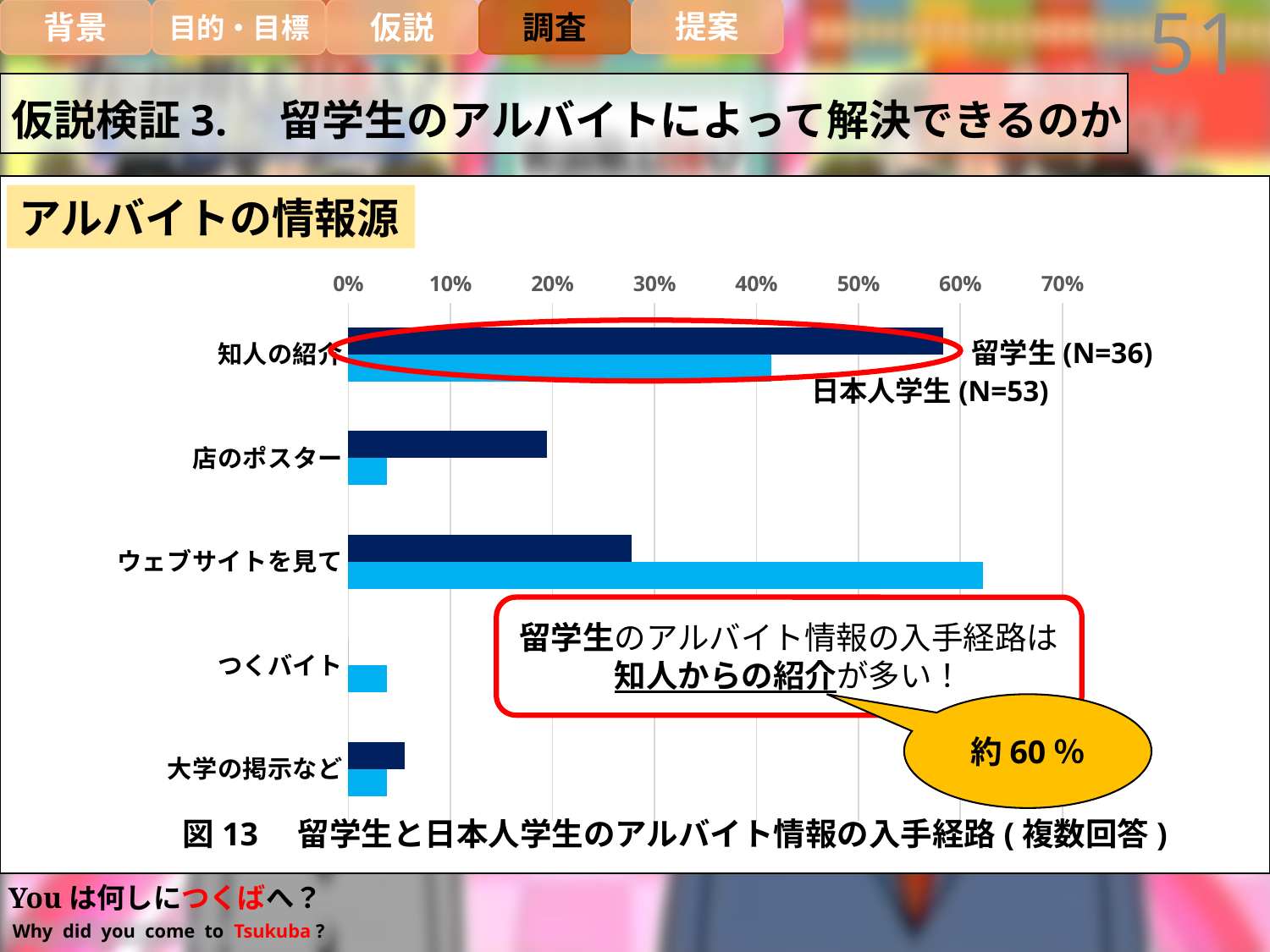
How many series does the chart's legend list? 2 What kind of chart is shown on the slide? bar chart What is the figure caption of the chart? 図13 留学生と日本人学生のアルバイト情報の入手経路(複数回答) Is the value for 日本人学生 (N=53) in ウェブサイトを見て greater or less than 60%? greater Is the value for 留学生 (N=36) in 知人の紹介 greater or less than 50%? greater For ウェブサイトを見て, which series has the larger value, 留学生 (N=36) or 日本人学生 (N=53)? 日本人学生 (N=53) Which category has the lowest value for 留学生 (N=36)? つくバイト How many categories (information sources) are plotted on the chart? 5 Which category has the highest value for 日本人学生 (N=53)? ウェブサイトを見て Which category has the highest value for 留学生 (N=36)? 知人の紹介 For 知人の紹介, which series has the larger value, 留学生 (N=36) or 日本人学生 (N=53)? 留学生 (N=36)